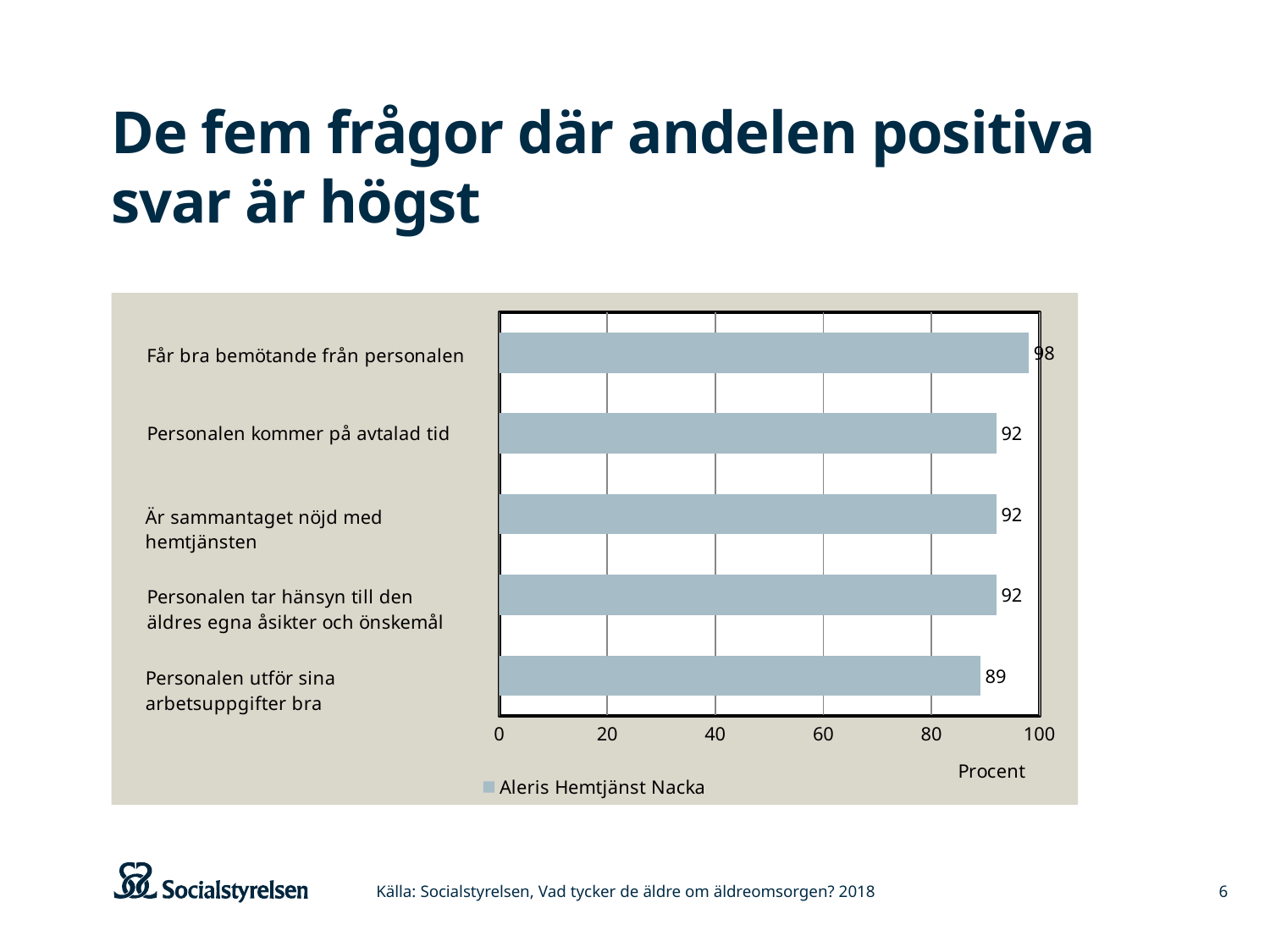
What is the value for "Personalen kommer på avtalad tid"? 92 How many categories are shown in the chart? 5 Which category has the lowest value? Personalen utför sina arbetsuppgifter bra Which is larger: the value for "Är sammantaget nöjd med hemtjänsten" or the value for "Personalen utför sina arbetsuppgifter bra"? Är sammantaget nöjd med hemtjänsten What is the value for "Personalen utför sina arbetsuppgifter bra"? 89 What is the value for "Får bra bemötande från personalen"? 98 What is the difference between the values for "Får bra bemötande från personalen" and "Personalen utför sina arbetsuppgifter bra"? 9 Is the value for "Personalen utför sina arbetsuppgifter bra" greater or less than 80? greater How many series does the legend list? 1 What kind of chart is shown on the slide? bar chart What is the name of the series shown in the legend? Aleris Hemtjänst Nacka Which category has the highest value? Får bra bemötande från personalen